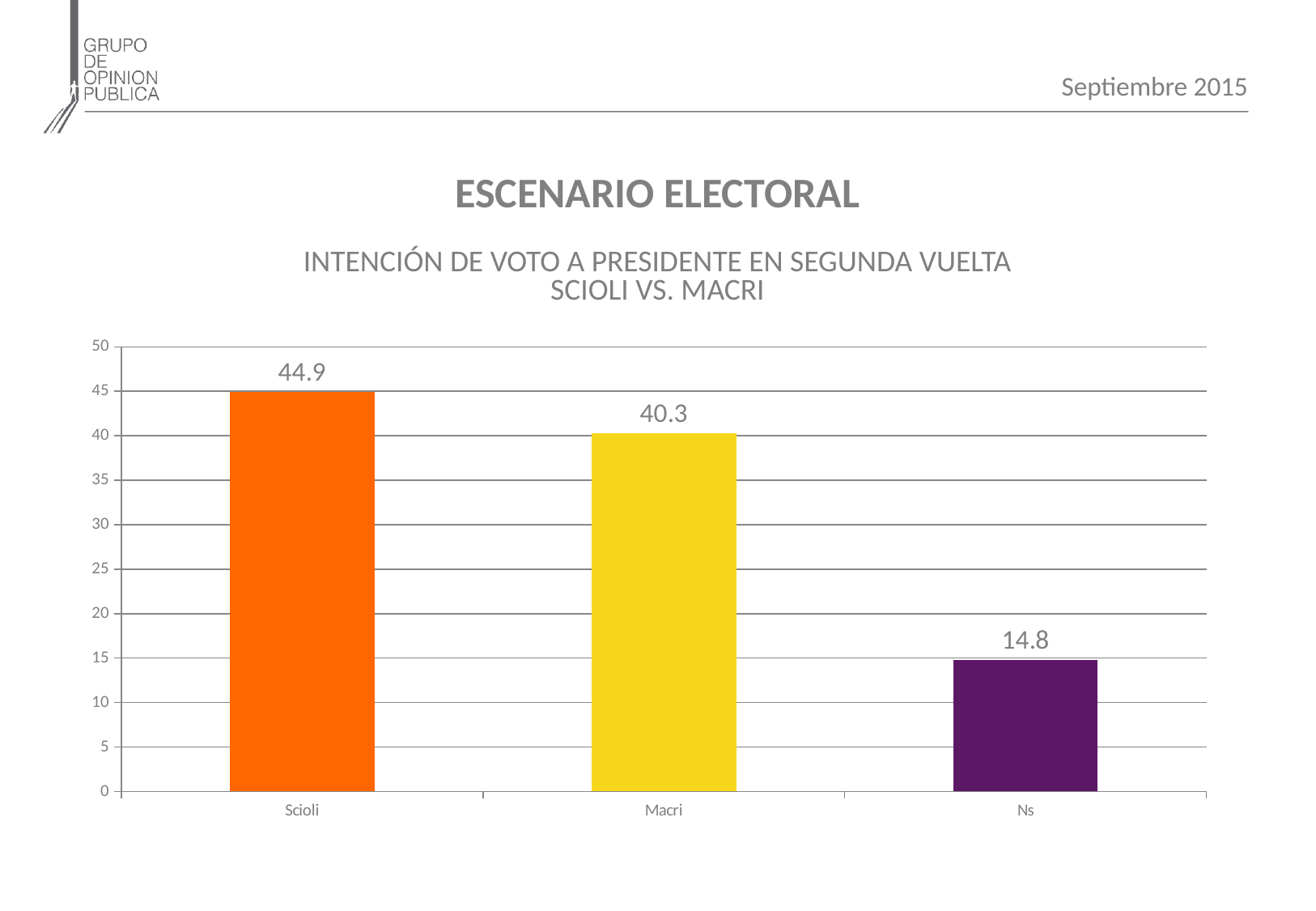
Which category has the highest value? Scioli What is the value for Scioli? 44.9 Which is larger, the value for Scioli or the value for Macri? Scioli What colour is the bar for Macri? yellow How many categories are shown on the x axis? 3 What is the value for Ns? 14.8 What is the difference between the values for Macri and Ns? 25.5 What is the value for Macri? 40.3 Is the value for Ns greater or less than 20? less Which category has the lowest value? Ns What kind of chart is shown on the slide? bar chart What is the difference between the values for Scioli and Macri? 4.6